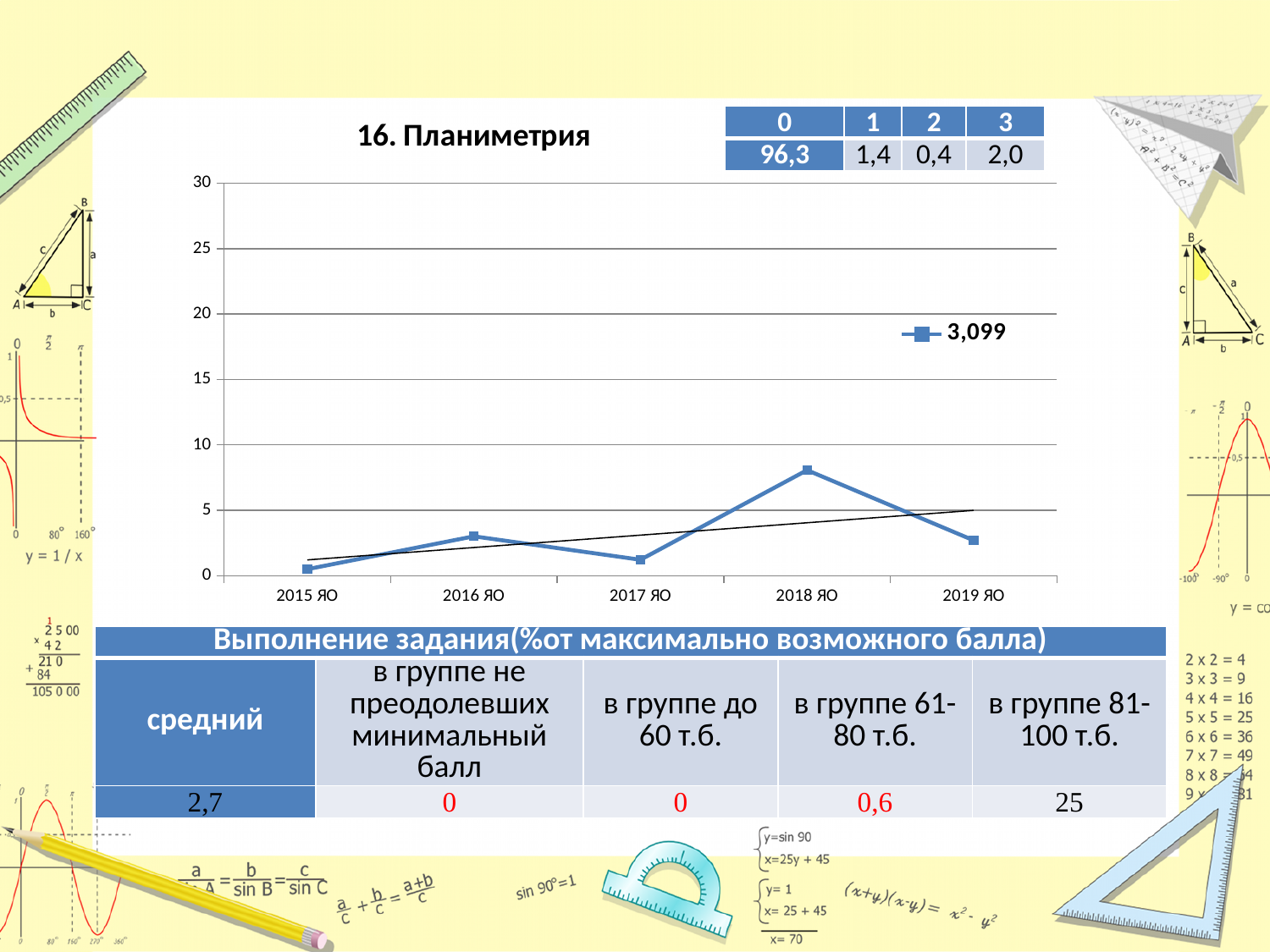
Is the value for 2018 ЯО greater or less than 5? greater Which year has the highest value on the chart? 2018 ЯО How many points are plotted along the x axis of the chart? 5 How many series does the chart legend list? 1 Which is larger, the value for 2018 ЯО or the value for 2019 ЯО? 2018 ЯО Which year has the lowest value on the chart? 2015 ЯО What is the title of the chart? 16. Планиметрия Does the value rise or fall from 2018 ЯО to 2019 ЯО? fall What is the legend entry for the plotted series? 3,099 Is the value for 2016 ЯО greater or less than 5? less What kind of chart is shown on the slide? line chart Is the value for 2018 ЯО greater or less than 10? less